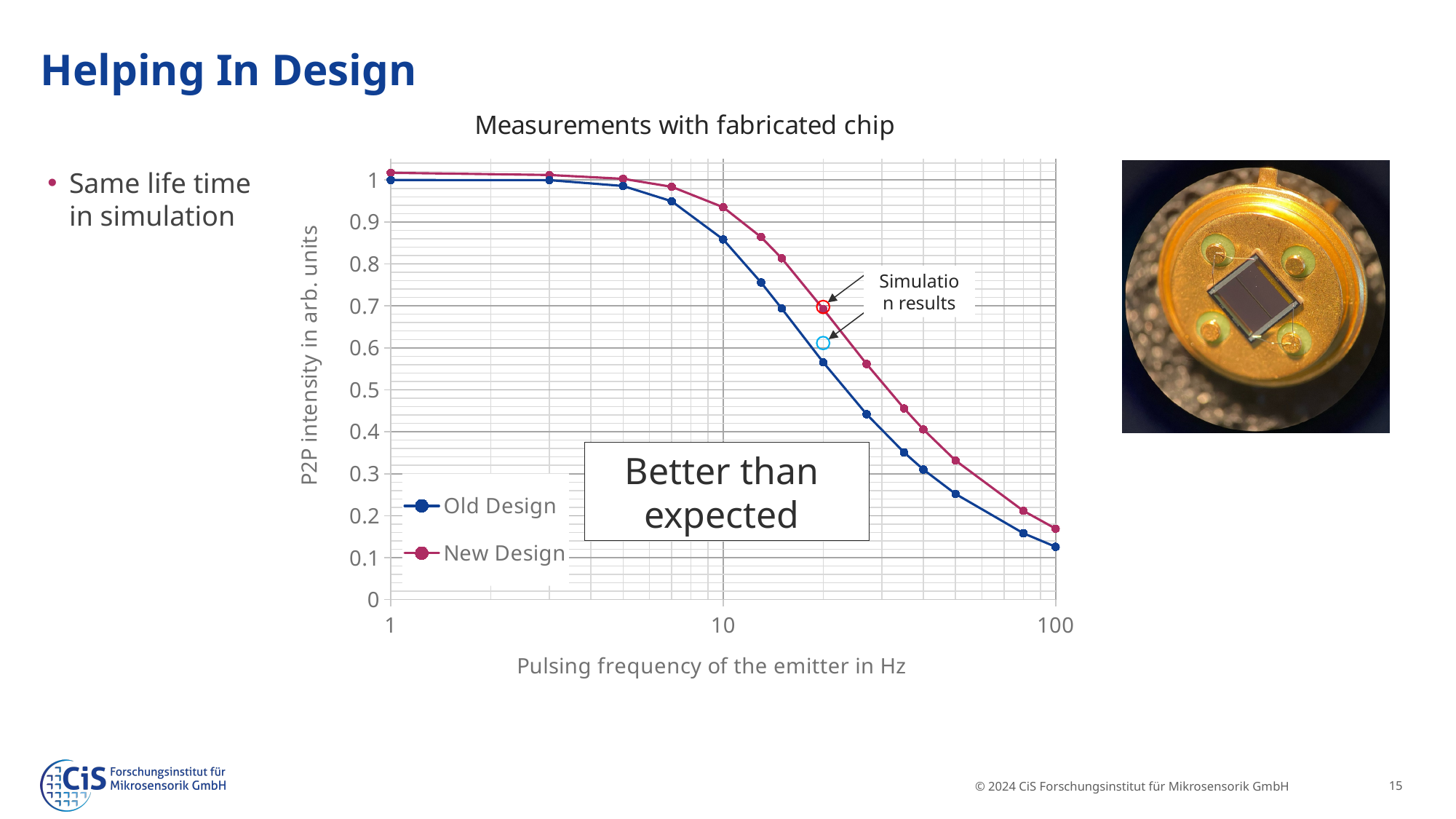
What is the title of the chart? Measurements with fabricated chip Is the New Design value at 20 Hz greater or less than 0.6? greater Is the Old Design value at 20 Hz greater or less than 0.5? greater At 100 Hz, which series has the higher P2P intensity, Old Design or New Design? New Design Is the Old Design value at 10 Hz greater or less than 0.8? greater How many series does the chart legend list? 2 At 10 Hz, which series has the lower P2P intensity, Old Design or New Design? Old Design What is the label of the x axis of the chart? Pulsing frequency of the emitter in Hz Do the P2P intensity values rise or fall as the pulsing frequency increases? fall What kind of chart is shown on the slide? line chart